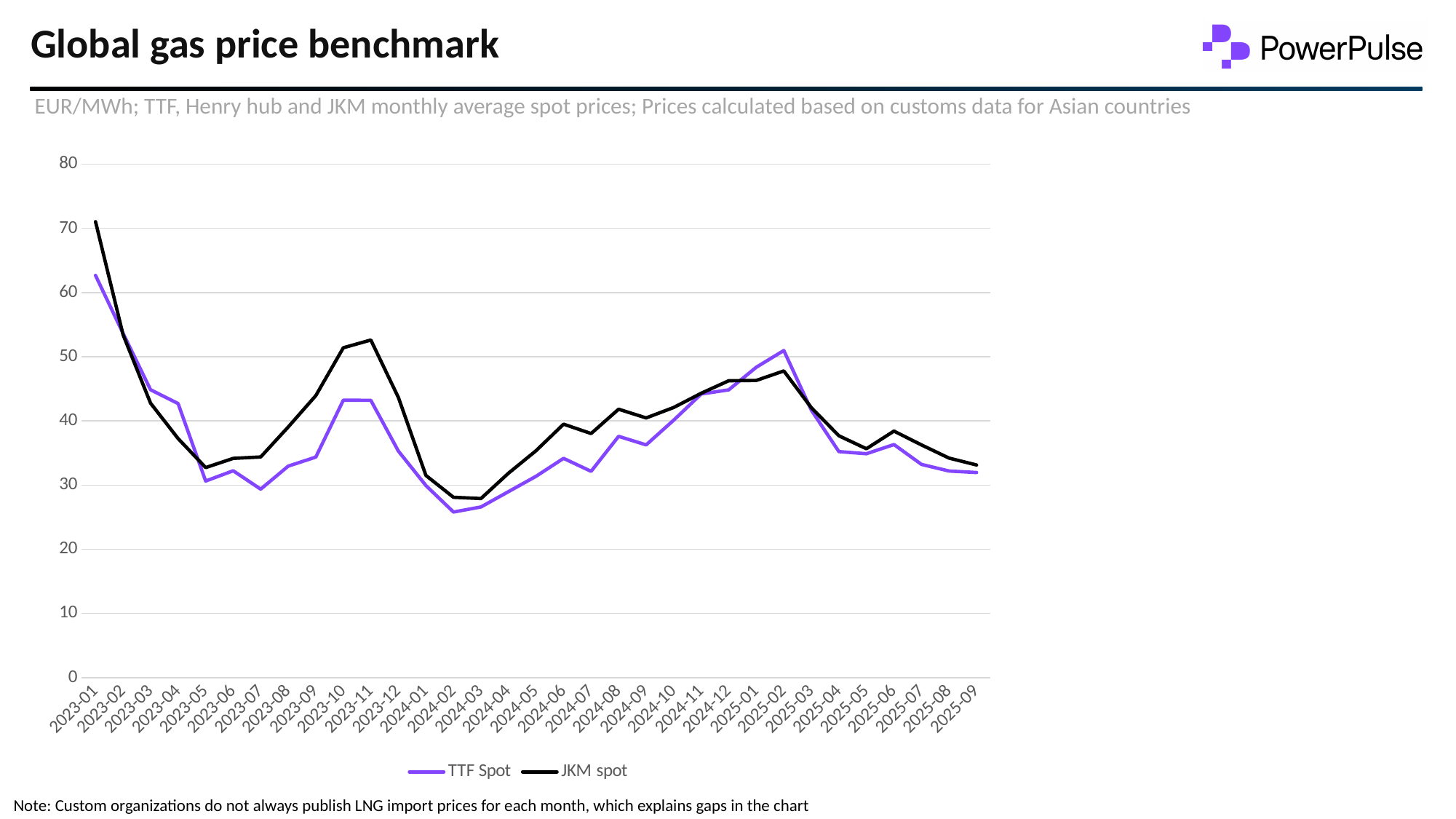
Is the value for TTF Spot in 2023-01 greater or less than 60? greater In which month does the JKM spot series reach its highest value? 2023-01 Is the value for JKM spot in 2023-10 greater or less than 50? greater What kind of chart is shown on the slide? Line chart In 2023-10, which series has the higher value, TTF Spot or JKM spot? JKM spot Is the value for JKM spot in 2024-02 greater or less than 30? less Does the TTF Spot series rise or fall from 2023-01 to 2023-05? Fall How many monthly points are plotted along the x axis? 33 In 2025-02, which series has the higher value, TTF Spot or JKM spot? TTF Spot In which month does the TTF Spot series reach its highest value? 2023-01 How many series does the legend list? 2